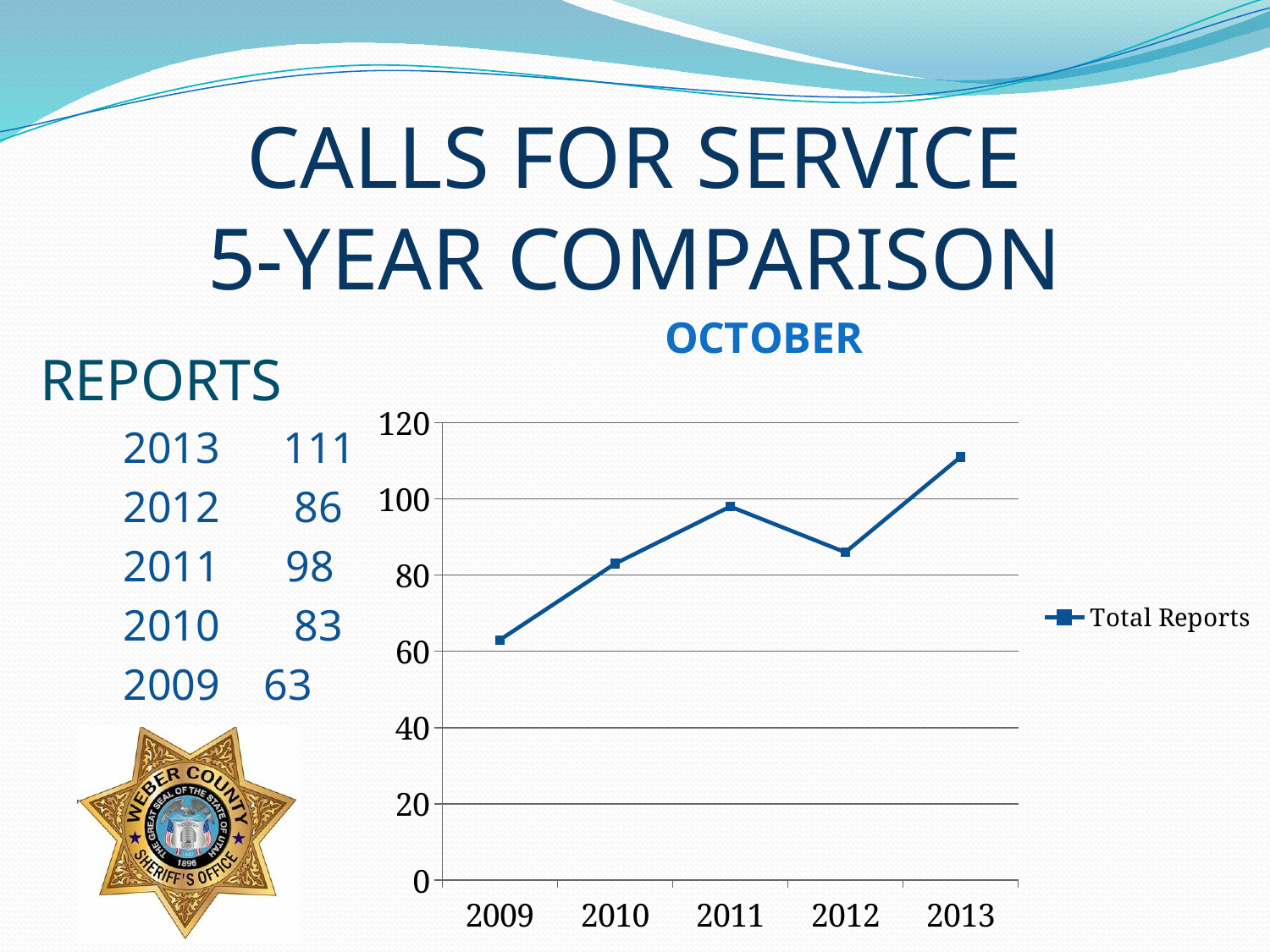
Which year has the lowest number of Total Reports? 2009 Which year has more Total Reports, 2011 or 2012? 2011 How many years are plotted on the x axis of the chart? 5 What is the name of the series shown in the chart legend? Total Reports Which year has the highest number of Total Reports? 2013 What kind of chart is shown on the slide? line chart What is the value of Total Reports for 2011? 98 How many series does the chart legend list? 1 What is the difference in Total Reports between 2013 and 2009? 48 Is the value for 2012 greater or less than 100? less What is the value of Total Reports for 2009? 63 What is the value of Total Reports for 2013? 111